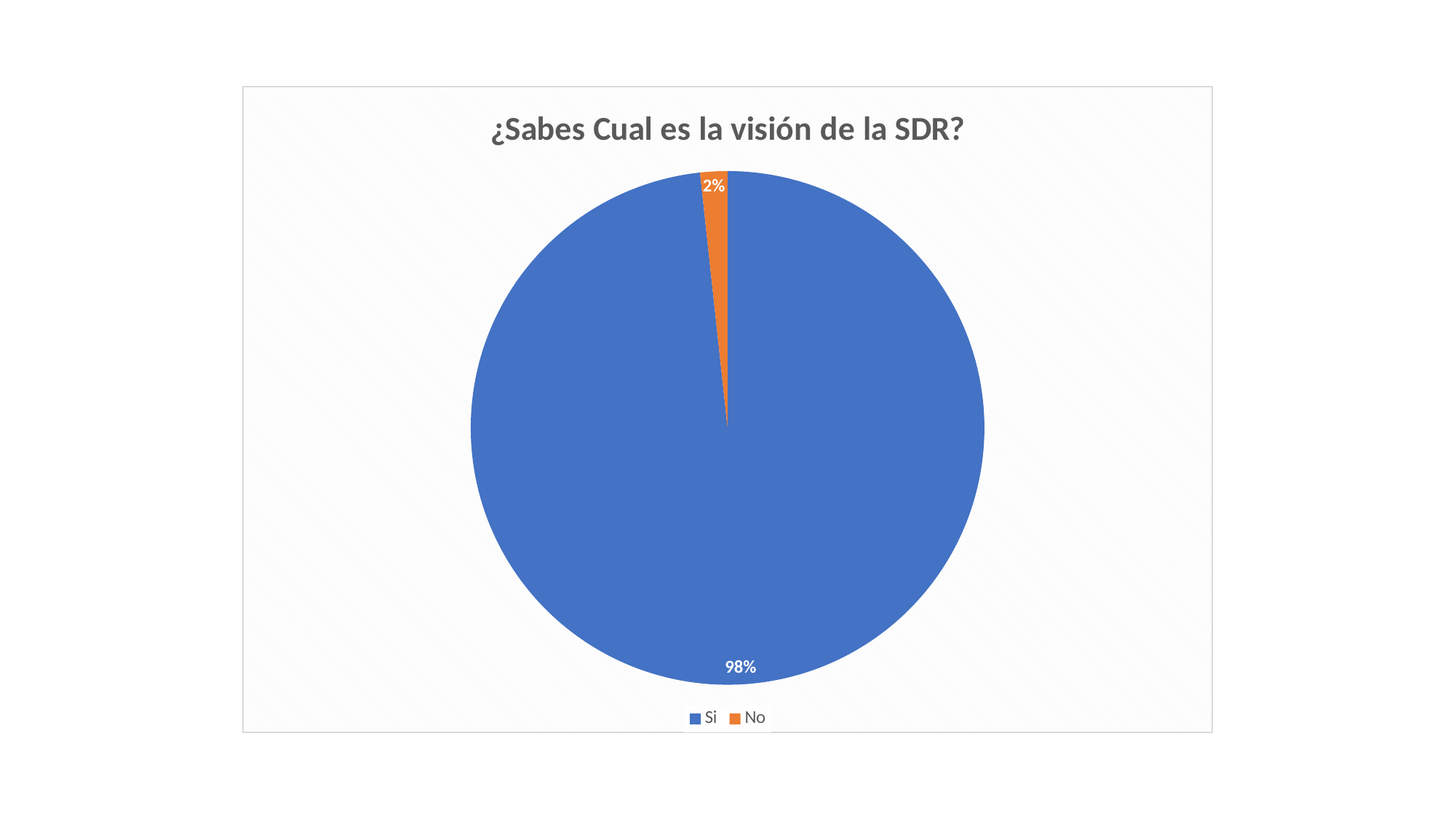
Which category has the smallest share of the pie? No What is the title of the chart? ¿Sabes Cual es la visión de la SDR? What type of chart is shown on the slide? pie chart How many entries does the legend list? 2 What colour is the 'No' slice? orange What percentage of the pie is labelled for 'Si'? 98% What is the difference in percentage points between 'Si' and 'No'? 96 Which category has the largest share of the pie? Si How many categories does the pie chart have? 2 What percentage of the pie is labelled for 'No'? 2% Which is larger, the share for 'Si' or the share for 'No'? Si What share of the pie does the 'Si' slice represent? 98%